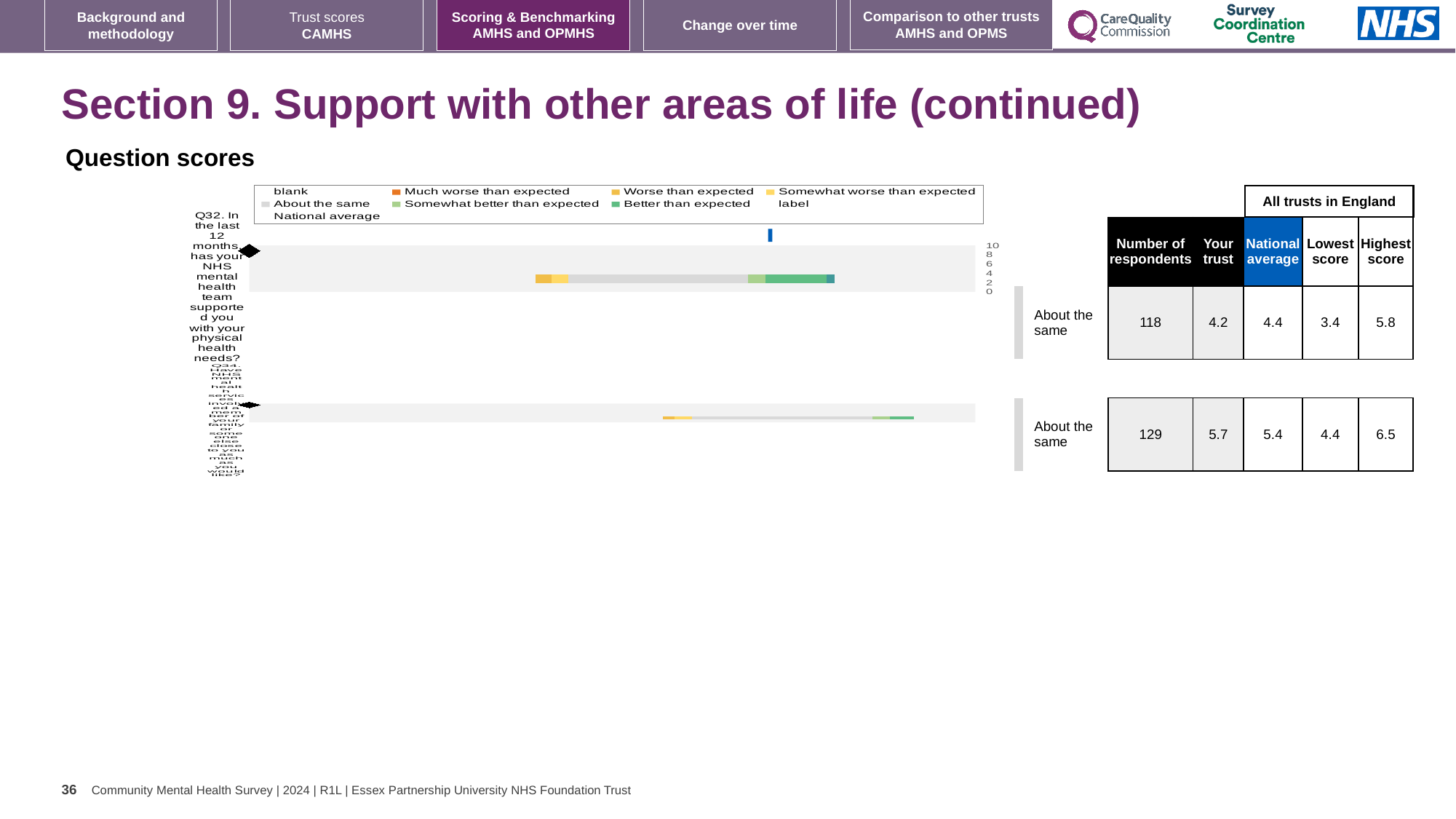
What is the highest value shown on the chart's numeric axis? 10 In the table beside the chart, what is the difference between the highest and lowest score for Q34? 2.1 In the table beside the chart, what is the highest score for Q34? 6.5 In the table beside the chart, what is the difference between the number of respondents for Q34 and Q32? 11 In the table beside the chart, what is the 'Your trust' score for Q34? 5.7 What kind of chart is shown under 'Question scores'? bar chart How many question bars are plotted in the chart? 2 In the table beside the chart, what is the national average for Q32? 4.4 In the table beside the chart, which is larger for Q32: the 'Your trust' score or the national average? National average How many entries does the chart legend list? 9 In the table beside the chart, how many respondents are listed for Q32? 118 What colour represents 'Much worse than expected' in the chart legend? orange